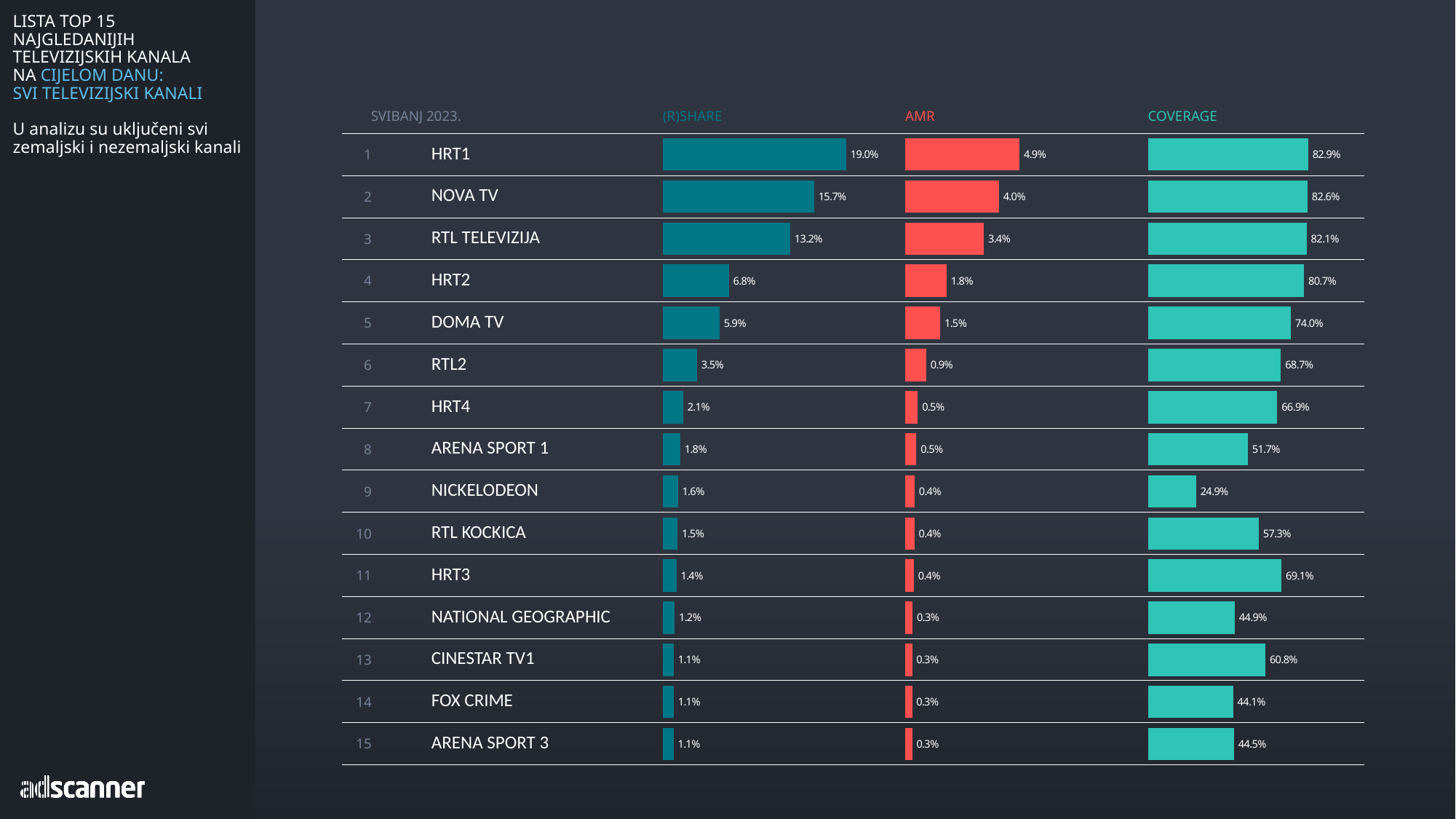
In the AMR chart, which is larger, the value for RTL TELEVIZIJA or the value for HRT2? RTL TELEVIZIJA In the (R)SHARE chart, what is the difference between HRT1 and NOVA TV? 3.3% In the COVERAGE chart, which channel has the lowest value? NICKELODEON In the AMR chart, what is the value for NOVA TV? 4.0% In the (R)SHARE chart, which channel has the highest value? HRT1 In the COVERAGE chart, what is the value for NICKELODEON? 24.9% Which month and year does the table header indicate the data is for? SVIBANJ 2023. How many channels are listed in the (R)SHARE chart? 15 What kind of chart is used to show the AMR values? bar chart In the COVERAGE chart, which is larger, the value for HRT3 or the value for RTL KOCKICA? HRT3 In the (R)SHARE chart, what is the value for HRT1? 19.0% In the COVERAGE chart, what is the difference between HRT1 and DOMA TV? 8.9%